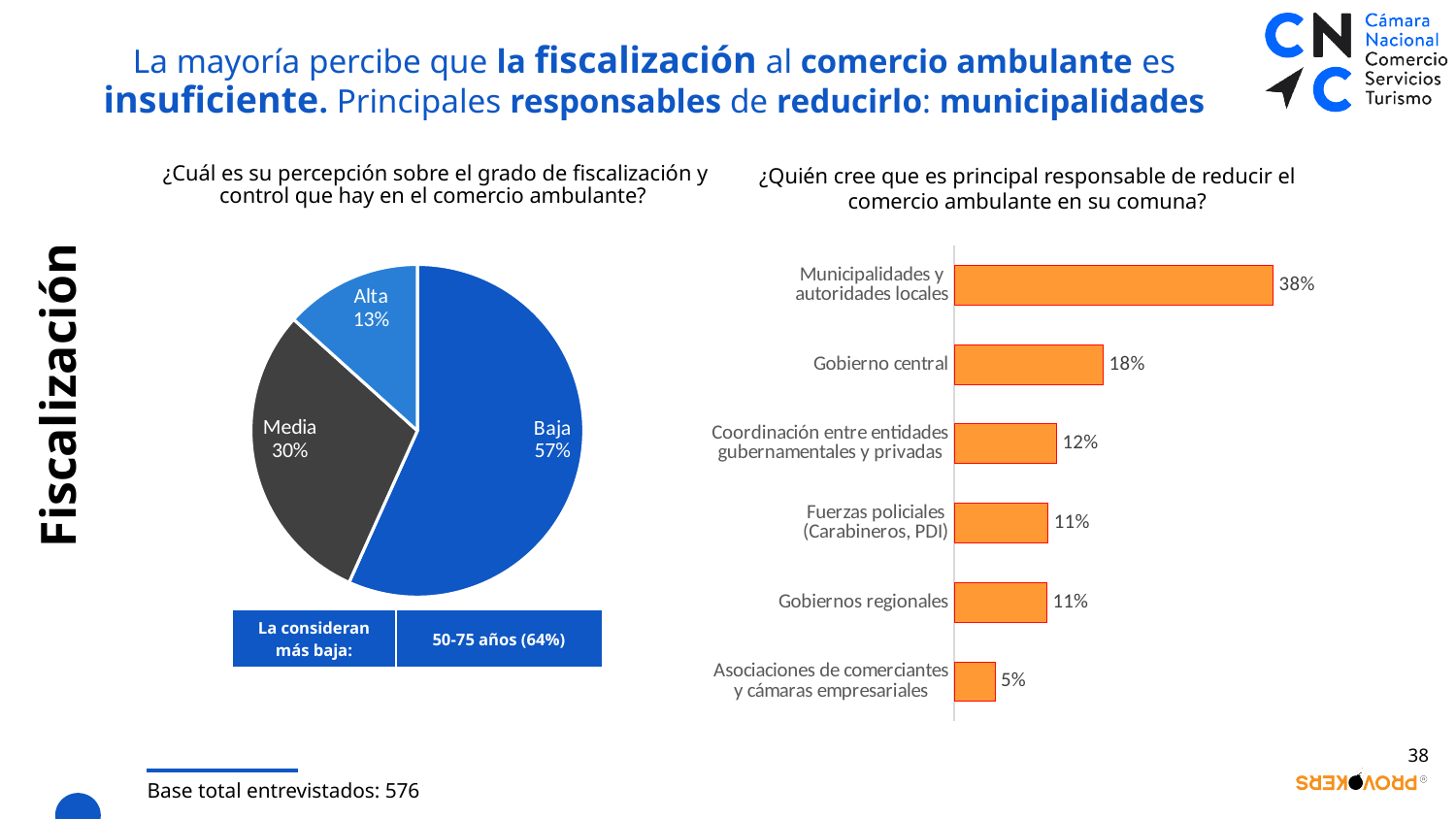
In the pie chart on the left, what is the difference in percentage points between "Baja" and "Media"? 27 What type of chart is shown on the left side of the slide? Pie chart In the bar chart on the right, how many categories are plotted? 6 In the bar chart on the right, what is the difference in percentage points between "Municipalidades y autoridades locales" and "Gobierno central"? 20 In the bar chart on the right, which category has the highest value? Municipalidades y autoridades locales In the pie chart on the left, what share of respondents perceive the level of control as "Baja"? 57% In the pie chart on the left, what percentage corresponds to "Alta"? 13% In the bar chart on the right, which is larger: the value for "Coordinación entre entidades gubernamentales y privadas" or for "Asociaciones de comerciantes y cámaras empresariales"? Coordinación entre entidades gubernamentales y privadas In the bar chart on the right, which category has the lowest value? Asociaciones de comerciantes y cámaras empresariales What type of chart is shown on the right side of the slide? Bar chart In the pie chart on the left, which category has the smallest slice? Alta In the bar chart on the right, what percentage is shown for "Gobierno central"? 18%